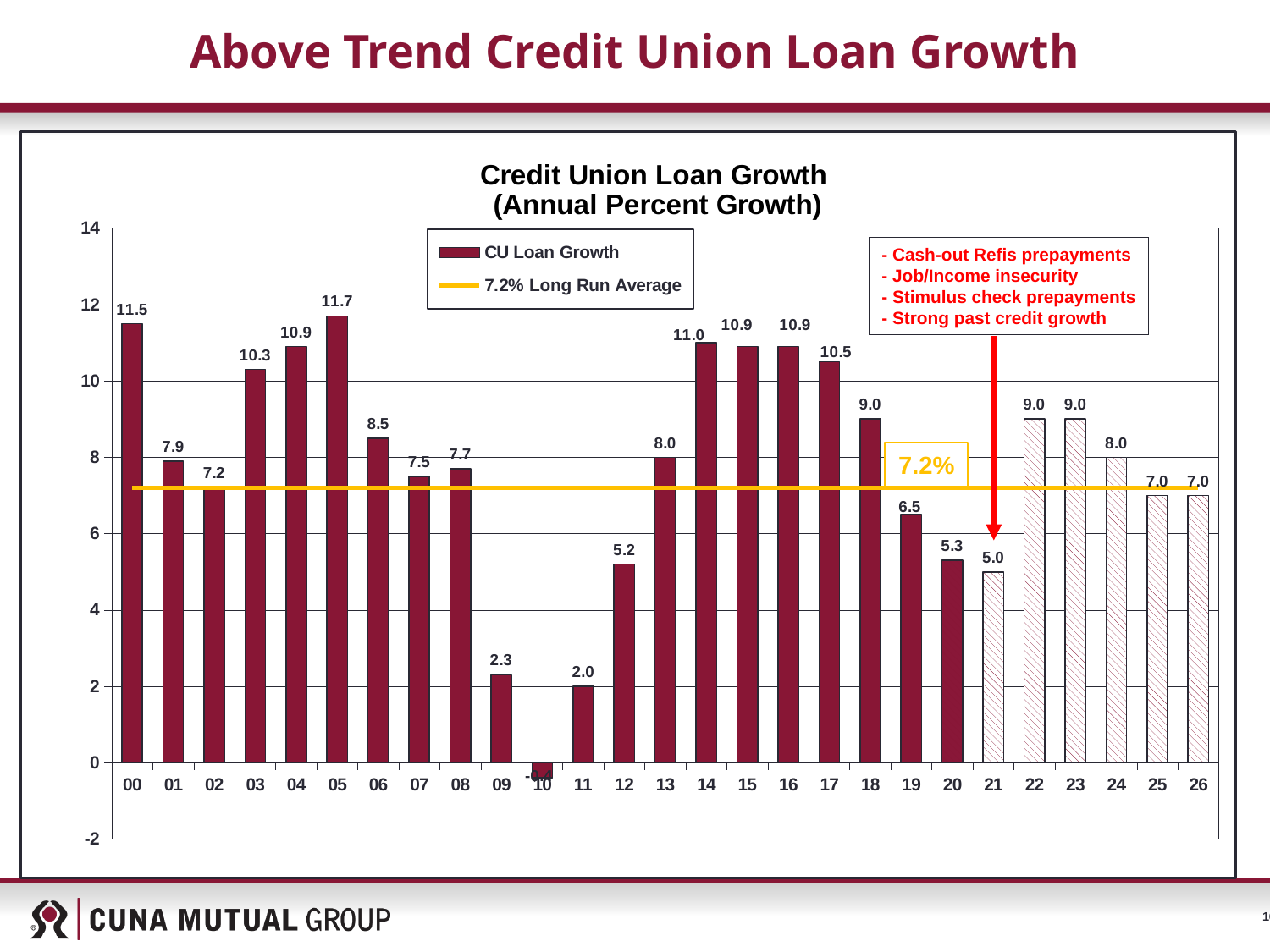
Is the CU Loan Growth value for 09 greater or less than 4? less Which year has the lowest CU Loan Growth value? 10 What is the difference between the CU Loan Growth values for 00 and 01? 3.6 What is the CU Loan Growth value for 19? 6.5 Which year has the highest CU Loan Growth value? 05 What is the CU Loan Growth value for 05? 11.7 Which is larger, the CU Loan Growth value for 12 or for 13? 13 What is the CU Loan Growth value for 21? 5.0 What kind of chart is shown on the slide? bar chart How many years are shown on the x axis of the chart? 27 What value does the long run average line in the chart represent? 7.2% How many entries does the chart legend list? 2